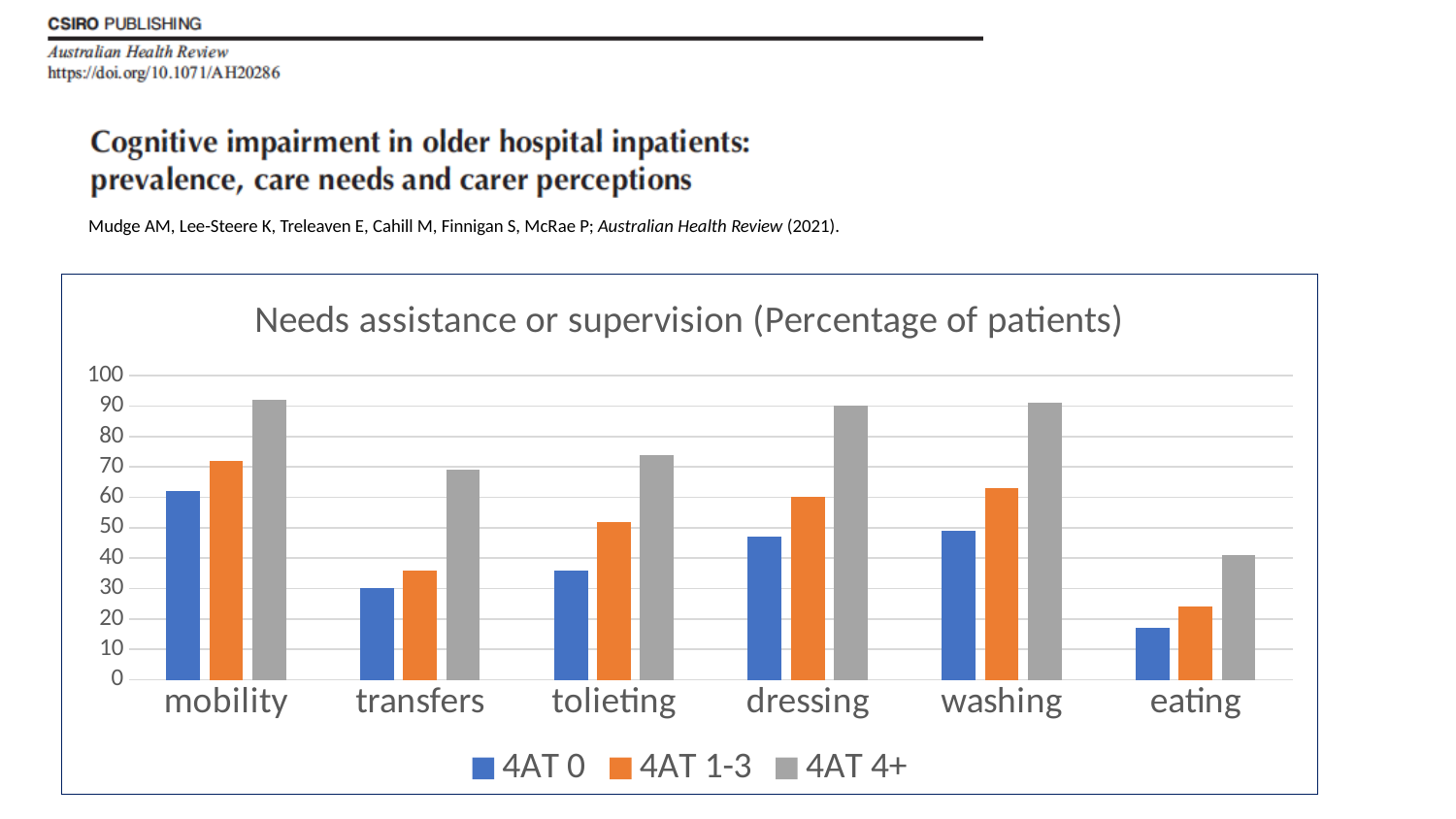
How many categories are shown on the x axis? 6 Which series has the tallest bar in every category? 4AT 4+ Which category has the lowest value for the 4AT 1-3 series? eating Is the value for 4AT 1-3 in the washing category greater or less than 70? less How many series does the legend list? 3 Which category has the highest value for the 4AT 0 series? mobility What kind of chart is shown on the slide? bar chart Is the value for 4AT 0 in the eating category greater or less than 20? less What is the title of the chart? Needs assistance or supervision (Percentage of patients) Is the value for 4AT 4+ in the mobility category greater or less than 80? greater For the 4AT 1-3 series, which is larger: mobility or transfers? mobility Which category has the lowest value for the 4AT 4+ series? eating